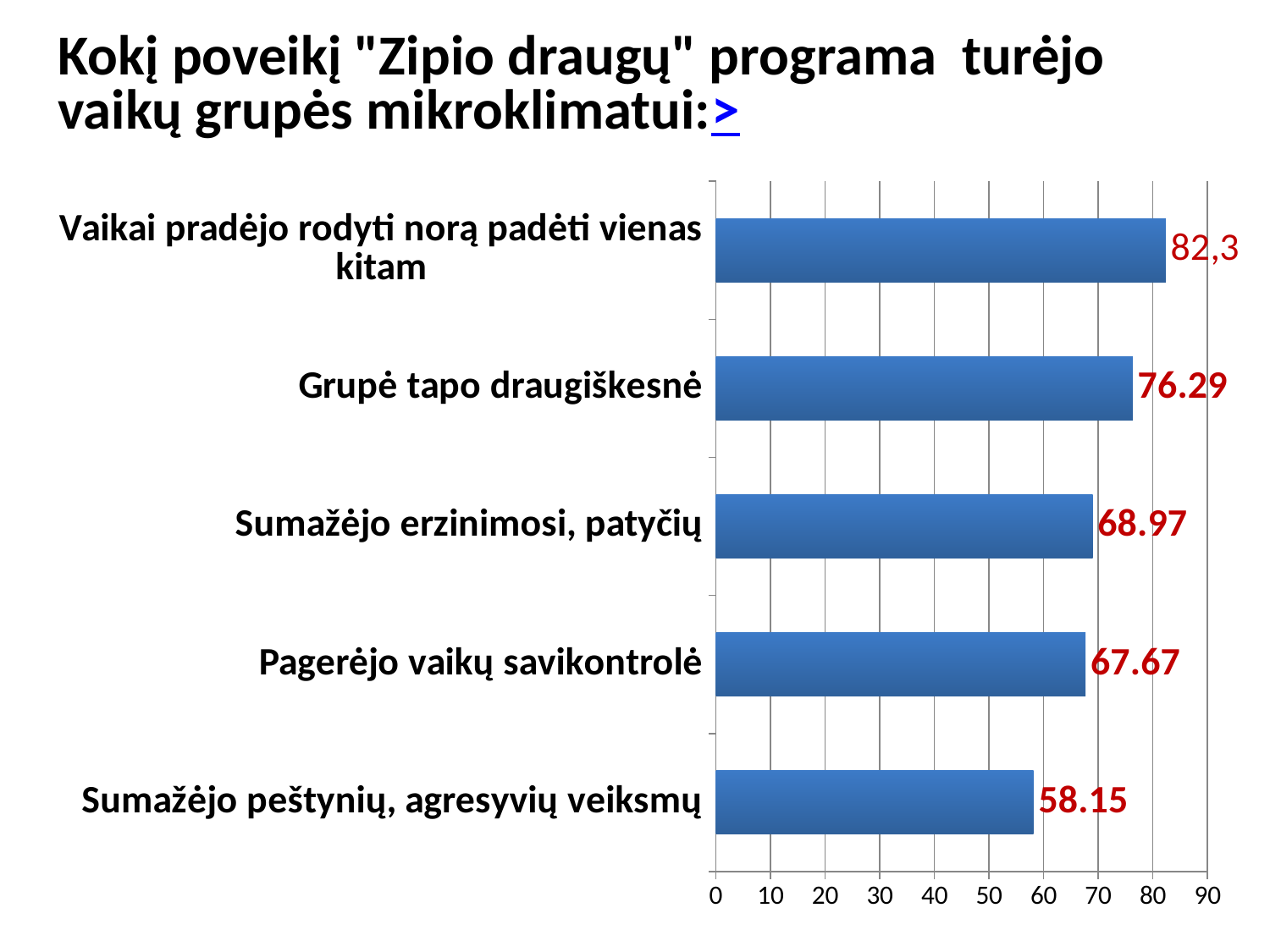
What is the difference between the values for "Pagerėjo vaikų savikontrolė" and "Sumažėjo peštynių, agresyvių veiksmų"? 9.52 Which is larger, the value for "Sumažėjo erzinimosi, patyčių" or the value for "Sumažėjo peštynių, agresyvių veiksmų"? Sumažėjo erzinimosi, patyčių Is the value for "Grupė tapo draugiškesnė" greater or less than 70? greater What value is shown for "Vaikai pradėjo rodyti norą padėti vienas kitam"? 82,3 What value is shown for "Grupė tapo draugiškesnė"? 76.29 How many categories are shown in the chart? 5 What kind of chart is shown on the slide? Bar chart What is the difference between the values for "Grupė tapo draugiškesnė" and "Sumažėjo erzinimosi, patyčių"? 7.32 Which category has the highest value? Vaikai pradėjo rodyti norą padėti vienas kitam Which category has the lowest value? Sumažėjo peštynių, agresyvių veiksmų What value is shown for "Pagerėjo vaikų savikontrolė"? 67.67 What value is shown for "Sumažėjo peštynių, agresyvių veiksmų"? 58.15